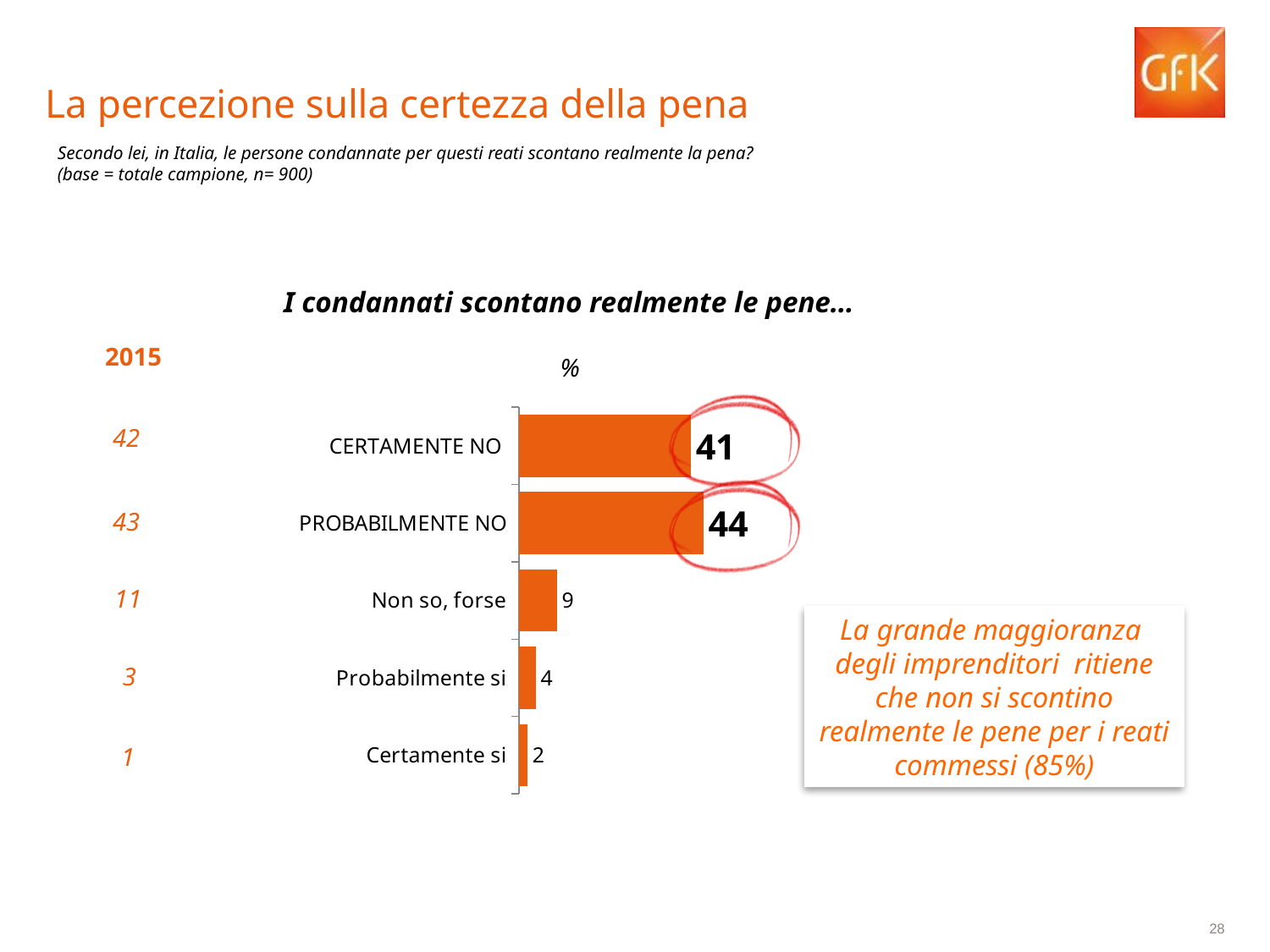
Which is larger, the value for Probabilmente si or the value for Certamente si? Probabilmente si What is the title of the chart? I condannati scontano realmente le pene… What is the difference between the values for PROBABILMENTE NO and CERTAMENTE NO? 3 What is the difference between the values for Non so, forse and Probabilmente si? 5 What value is shown for Certamente si in the chart? 2 What value is shown for CERTAMENTE NO in the chart? 41 What value is shown for Non so, forse in the chart? 9 What kind of chart is shown on the slide? Bar chart Which category has the lowest value in the chart? Certamente si Which category has the highest value in the chart? PROBABILMENTE NO How many categories are plotted in the chart? 5 What value is shown for PROBABILMENTE NO in the chart? 44